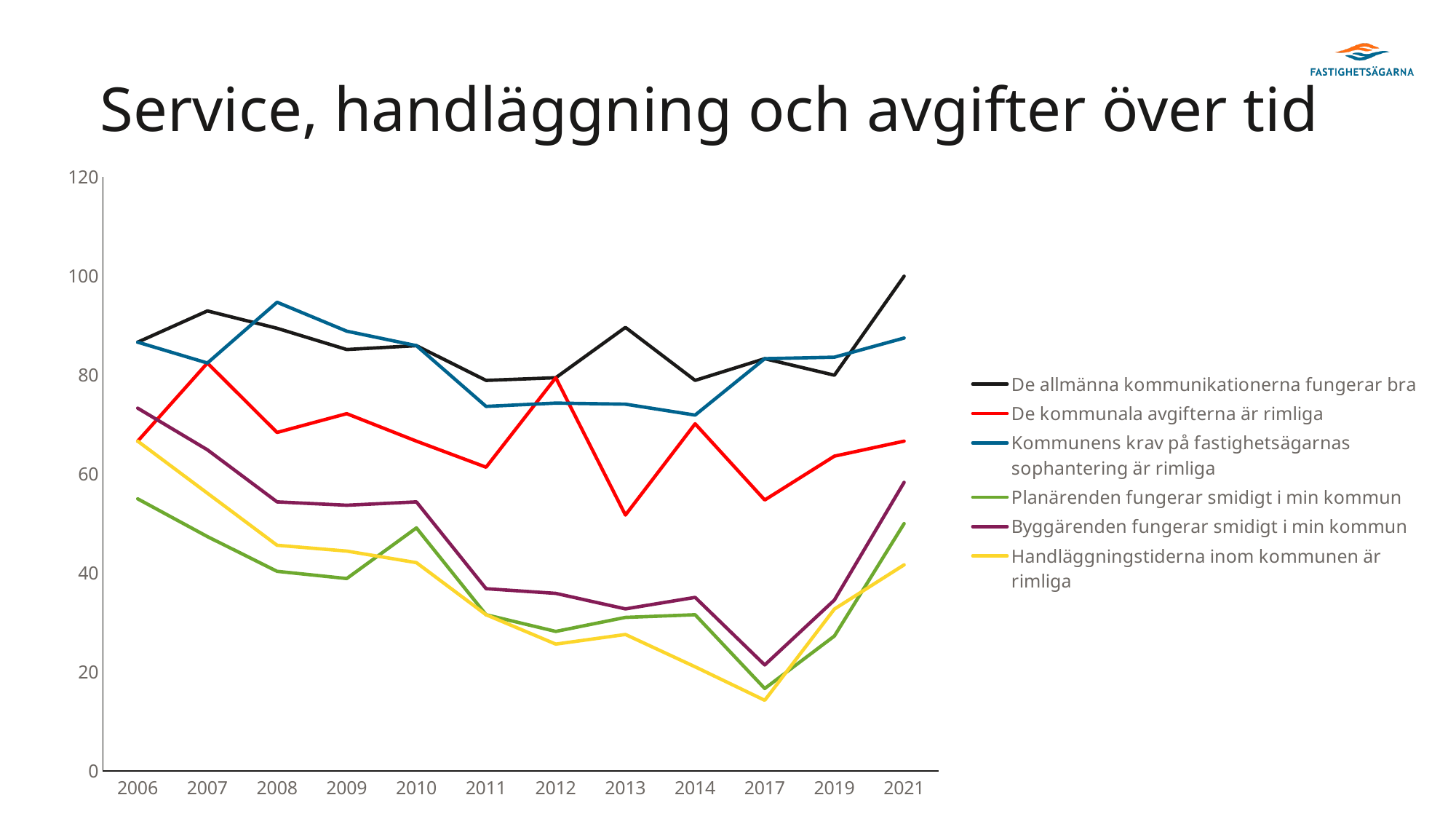
What kind of chart is shown on the slide? line chart Does the value for 'Handläggningstiderna inom kommunen är rimliga' rise or fall from 2006 to 2017? fall Which series has the lowest value in 2006? Planärenden fungerar smidigt i min kommun Is the value for 'De kommunala avgifterna är rimliga' in 2013 greater or less than 60? less Is the value for 'Byggärenden fungerar smidigt i min kommun' in 2021 greater or less than 40? greater How many years are shown along the x axis? 12 Which series has the highest value in 2021? De allmänna kommunikationerna fungerar bra How many series does the legend list? 6 Is the value for 'De allmänna kommunikationerna fungerar bra' in 2006 greater or less than 80? greater In 2008, which is larger: 'Kommunens krav på fastighetsägarnas sophantering är rimliga' or 'De allmänna kommunikationerna fungerar bra'? Kommunens krav på fastighetsägarnas sophantering är rimliga What colour is the line for 'De kommunala avgifterna är rimliga'? red